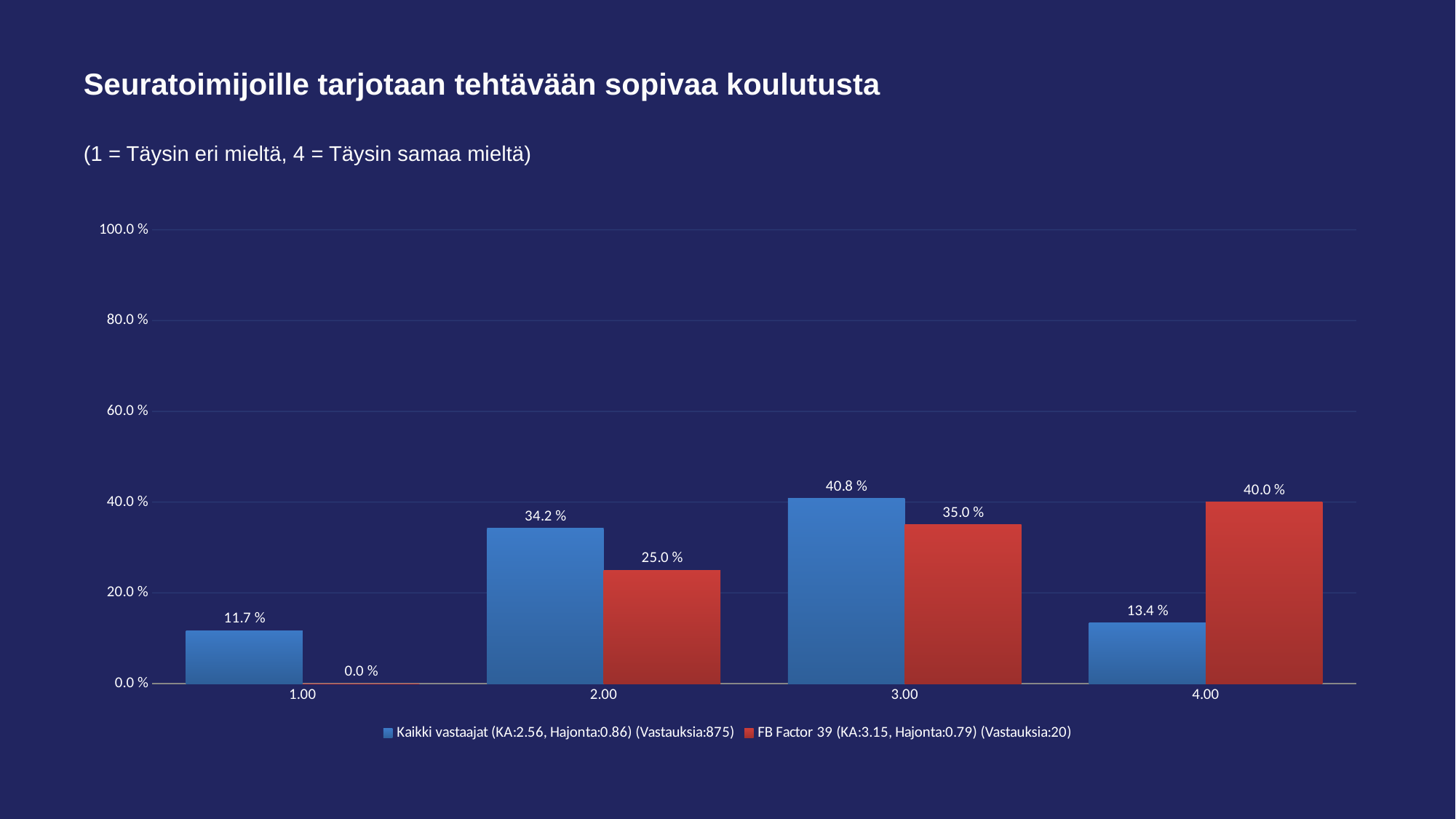
How many series does the legend list? 2 At category 4.00, which series has the larger value, Kaikki vastaajat or FB Factor 39? FB Factor 39 Which category has the highest value for Kaikki vastaajat? 3.00 What is the value for FB Factor 39 at category 1.00? 0.0 % What is the value for Kaikki vastaajat at category 3.00? 40.8 % Which category has the lowest value for FB Factor 39? 1.00 What is the difference between the Kaikki vastaajat and FB Factor 39 values at category 2.00? 9.2 % What is the value for FB Factor 39 at category 4.00? 40.0 % Is the value for Kaikki vastaajat at category 3.00 greater or less than 40.0 %? greater What kind of chart is shown on the slide? Bar chart What is the value for Kaikki vastaajat at category 2.00? 34.2 % How many categories are shown on the x axis? 4